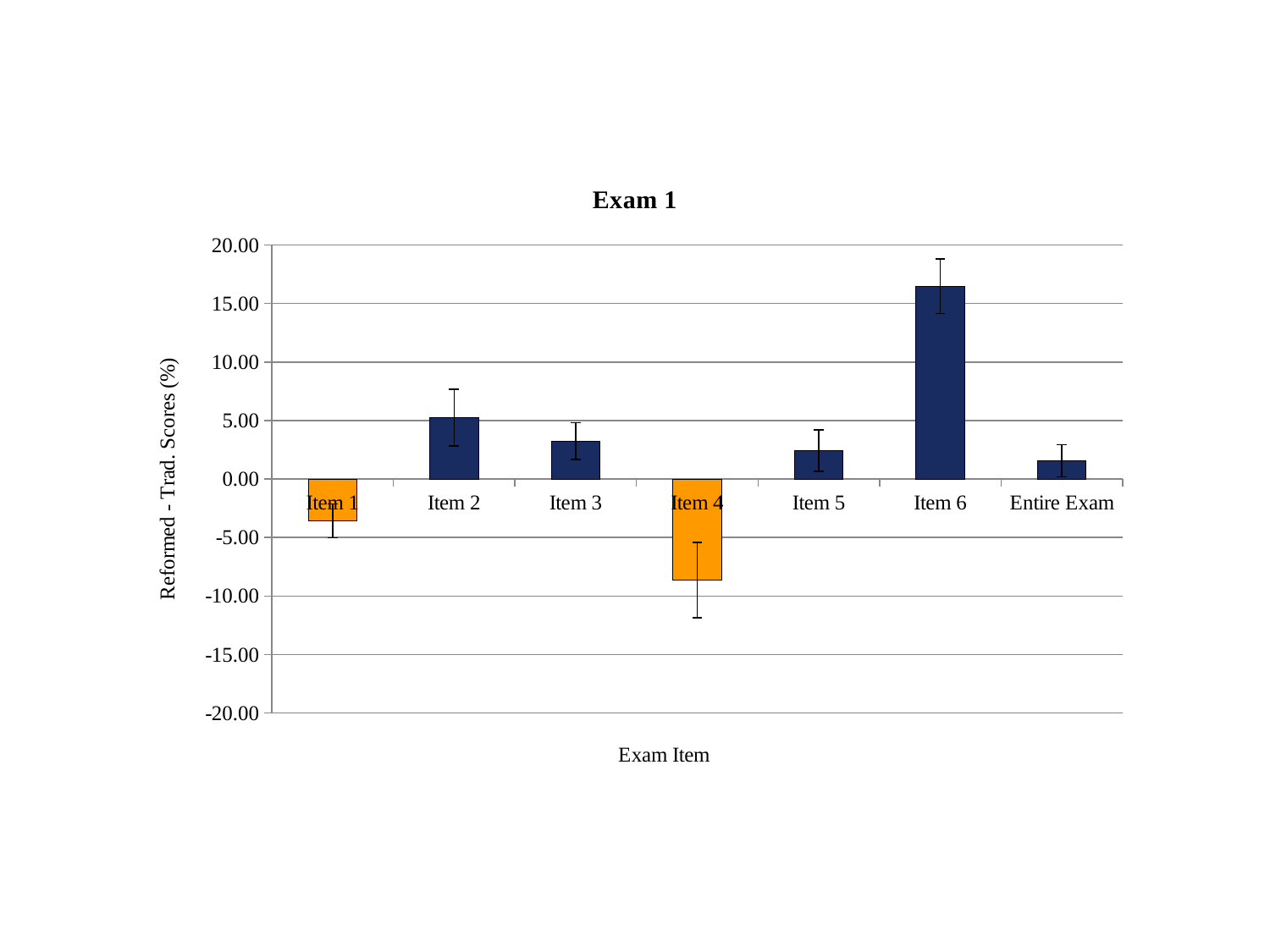
Is the value for Item 6 greater or less than 15.00? greater Which category has the highest value? Item 6 Is the value for Item 2 greater or less than 10.00? less How many categories are plotted along the x axis? 7 What is the title of the chart? Exam 1 What kind of chart is shown on the slide? bar chart Which category has the lowest value? Item 4 Is the value for Item 1 greater or less than 0.00? less What is the label of the y axis? Reformed - Trad. Scores (%) Which is larger, the value for Item 2 or the value for Item 5? Item 2 Which is larger, the value for Item 3 or the value for Entire Exam? Item 3